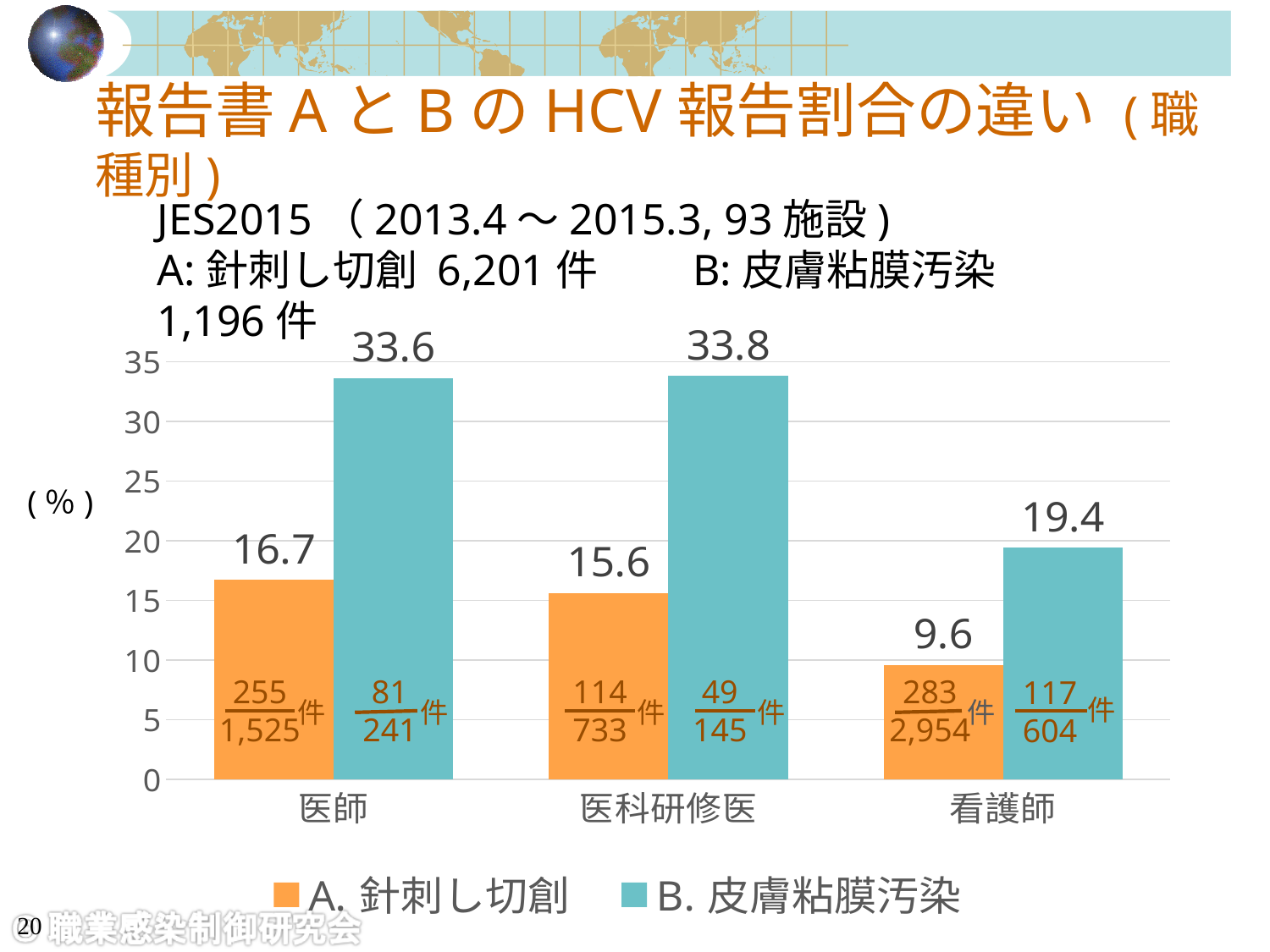
What is the value for 医師 in series A. 針刺し切創? 16.7 How many categories are shown on the x axis? 3 Which category has the lowest value in series A. 針刺し切創? 看護師 Which category has the highest value in series B. 皮膚粘膜汚染? 医科研修医 What is the value for 医科研修医 in series B. 皮膚粘膜汚染? 33.8 What is the value for 看護師 in series A. 針刺し切創? 9.6 How many series does the legend list? 2 Which is larger for 看護師: the A. 針刺し切創 value or the B. 皮膚粘膜汚染 value? B. 皮膚粘膜汚染 What is the difference between the B. 皮膚粘膜汚染 value and the A. 針刺し切創 value for 医師? 16.9 What unit is shown on the y axis label? (%) What is the value for 看護師 in series B. 皮膚粘膜汚染? 19.4 What kind of chart is shown on the slide? Bar chart